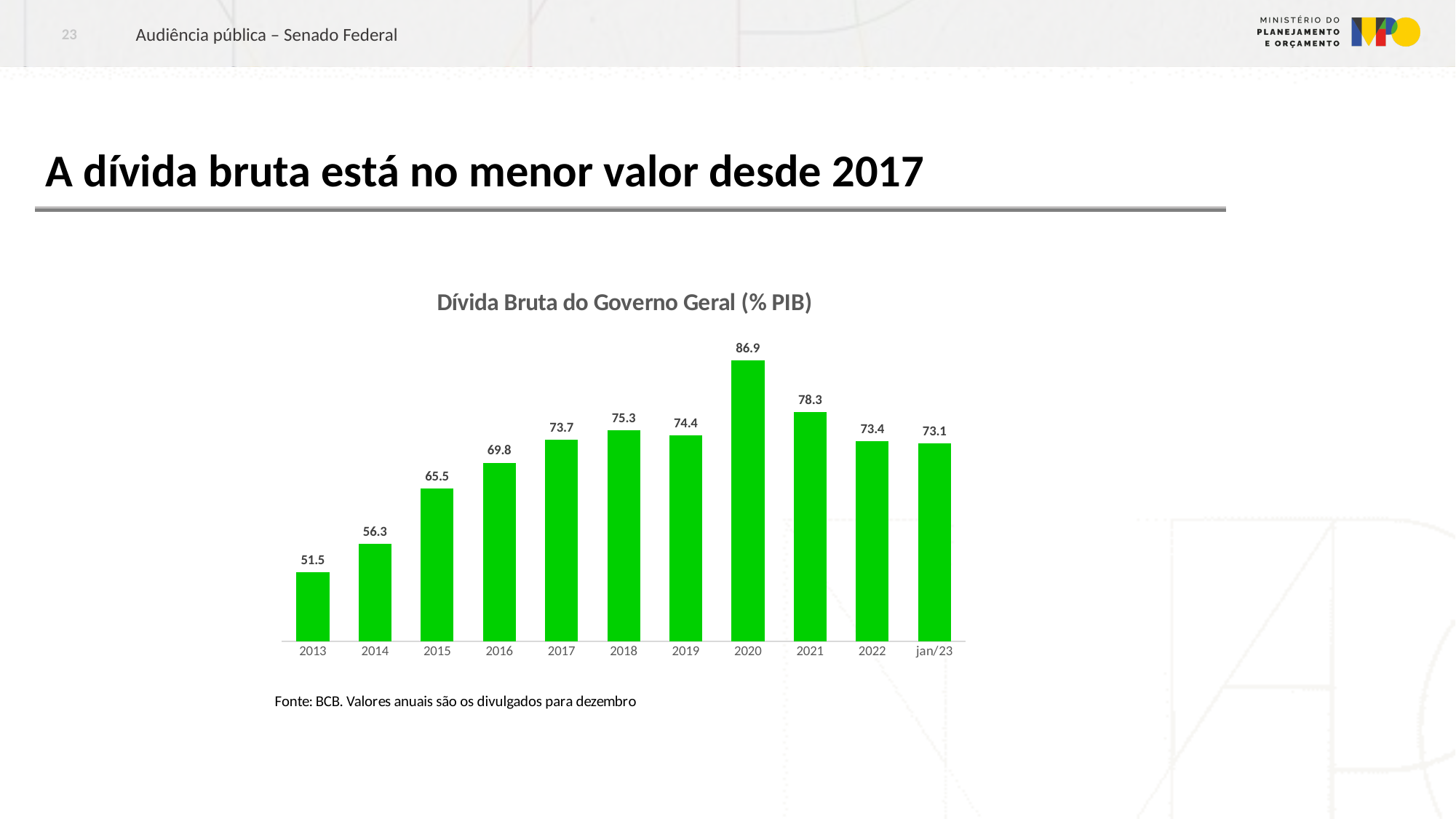
What is the value for 2020? 86.9 What is the value for jan/23? 73.1 What is the title of the chart? Dívida Bruta do Governo Geral (% PIB) What is the value for 2013? 51.5 Do the values rise or fall from 2013 to 2020? rise What is the difference between the values for 2020 and 2021? 8.6 Which category has the lowest value? 2013 What is the difference between the values for 2022 and jan/23? 0.3 What kind of chart is this? bar chart Which category has the highest value? 2020 How many categories are shown on the x axis? 11 Which is larger, the value for 2018 or the value for 2019? 2018